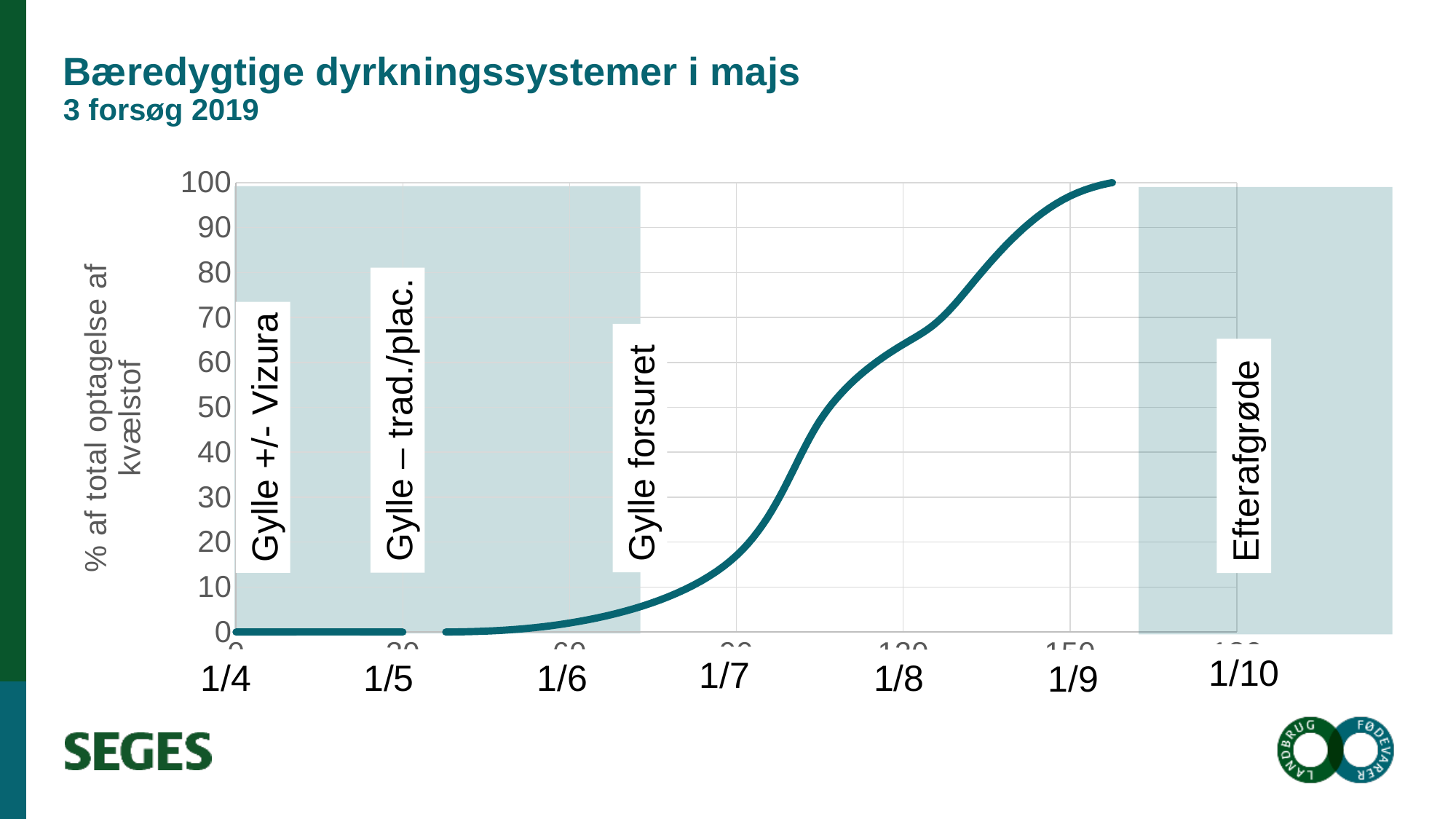
What kind of chart is shown on the slide? line chart What is the label on the y axis of the chart? % af total optagelse af kvælstof Is the value of the curve at 1/8 greater or less than 70? less Does the plotted curve rise or fall as the dates move from 1/4 to 1/10? rise Is the value of the curve at 1/6 greater or less than 10? less How many date labels are shown along the x axis? 7 What is the highest value the curve reaches on the y axis? 100 Is the value of the curve at 1/8 greater or less than 50? greater What is the text label in the rightmost shaded region of the chart? Efterafgrøde Which is larger, the value of the curve at 1/7 or at 1/8? 1/8